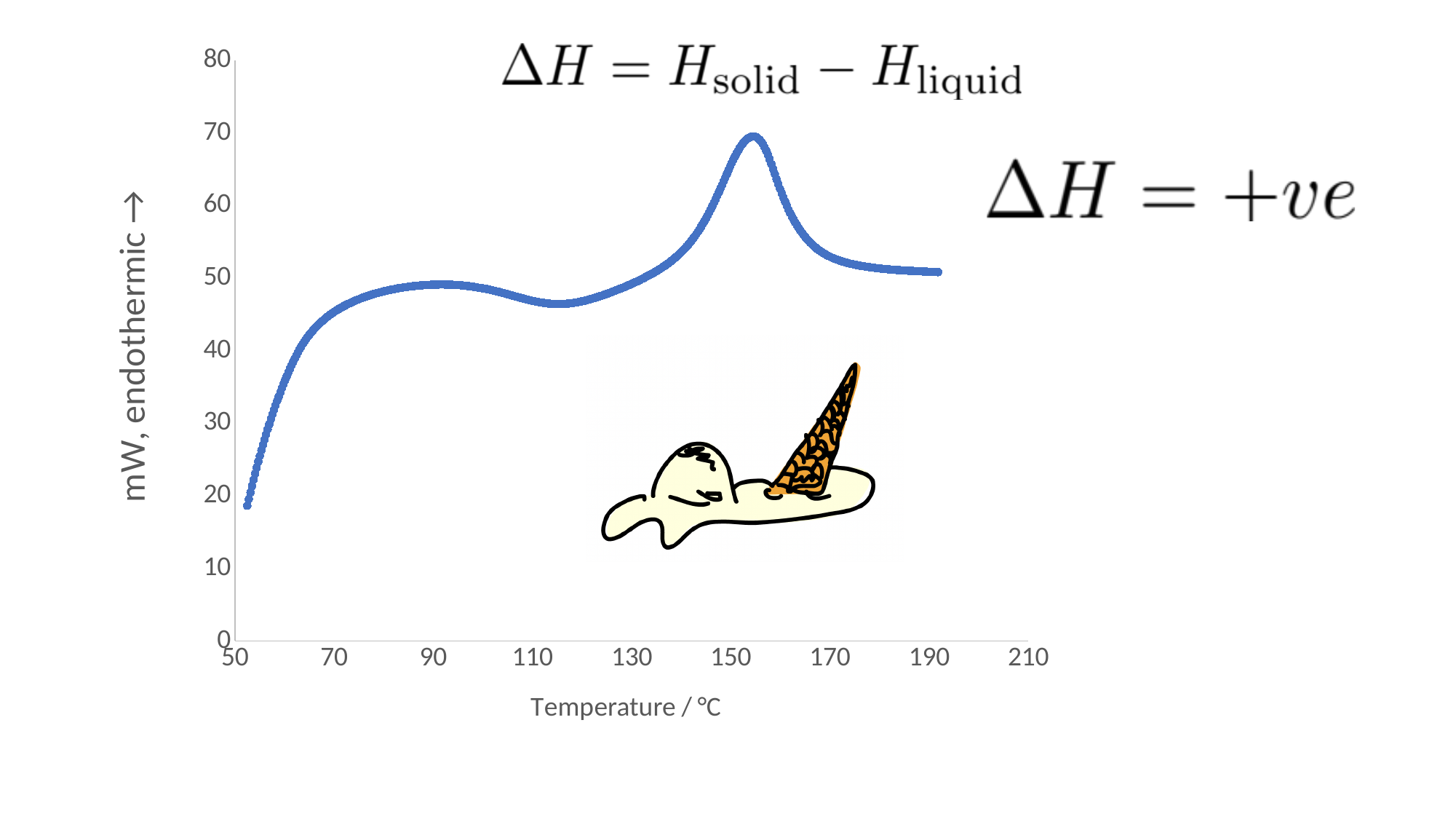
Is the value at 110 °C greater or less than 50? less Does the curve rise or fall between 160 °C and 190 °C? fall How many data series are plotted on the chart? 1 Is the peak value of the curve greater or less than 60? greater What is the label of the y axis? mW, endothermic → Is the value at 70 °C greater or less than 50? less Does the curve rise or fall between 50 °C and 90 °C? rise What is the label of the x axis? Temperature / °C What kind of chart is shown on the slide? line chart Which is larger, the value at 150 °C or the value at 70 °C? 150 °C